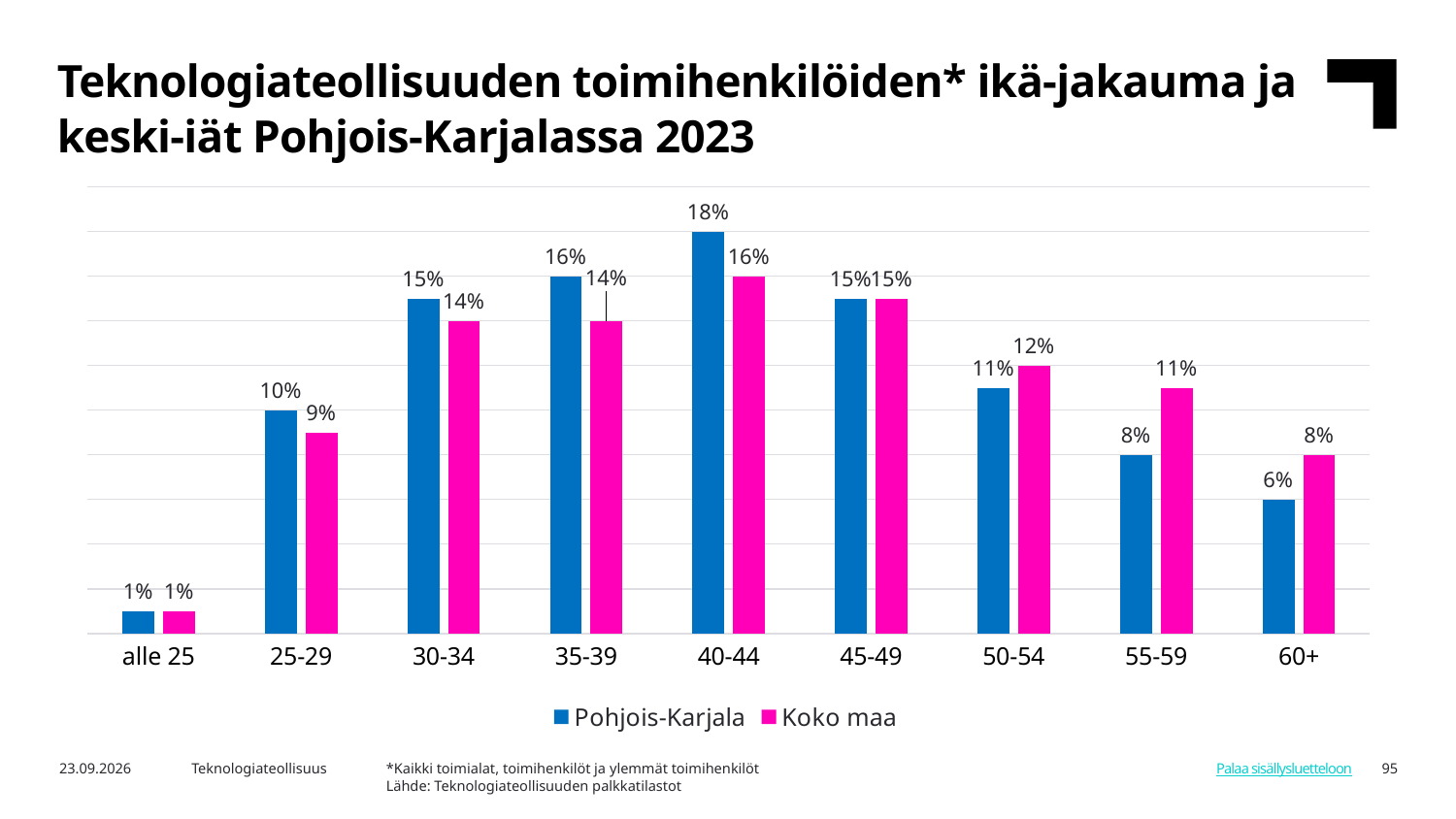
Which is larger in the 60+ age group, Pohjois-Karjala or Koko maa? Koko maa What is the value for Pohjois-Karjala in the 40-44 age group? 18% How many series does the legend list? 2 Do the Pohjois-Karjala values rise or fall from the 40-44 age group to the 60+ age group? Fall How many age groups are shown on the x axis? 9 Which age group has the lowest value for Koko maa? alle 25 What is the value for Koko maa in the 55-59 age group? 11% What is the value for Koko maa in the 25-29 age group? 9% Which colour represents Koko maa in the legend? Pink (magenta) What is the difference between Pohjois-Karjala and Koko maa in the 35-39 age group? 2 percentage points What kind of chart is shown on the slide? Bar chart Which age group has the highest value for Pohjois-Karjala? 40-44